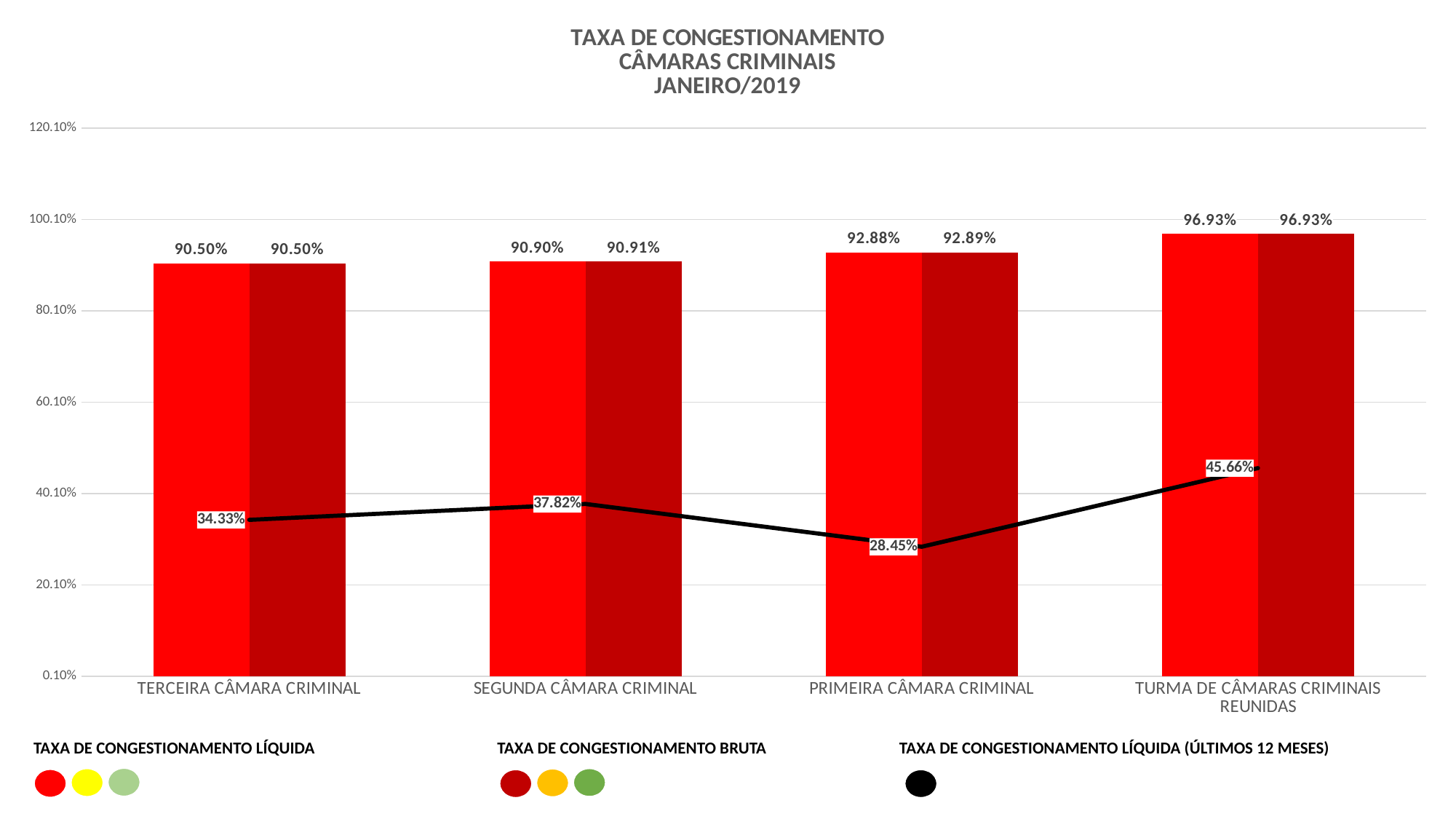
Which category has the highest Taxa de Congestionamento Bruta? Turma de Câmaras Criminais Reunidas What is the Taxa de Congestionamento Bruta for Segunda Câmara Criminal? 90.91% What is the Taxa de Congestionamento Líquida (últimos 12 meses) value for Primeira Câmara Criminal? 28.45% Which category has the lowest Taxa de Congestionamento Líquida (últimos 12 meses) value on the line? Primeira Câmara Criminal Which is larger: the Taxa de Congestionamento Líquida (últimos 12 meses) for Segunda Câmara Criminal or for Terceira Câmara Criminal? Segunda Câmara Criminal What kind of chart is shown on the slide? Combined bar and line chart What is the title of the chart? TAXA DE CONGESTIONAMENTO CÂMARAS CRIMINAIS JANEIRO/2019 What is the Taxa de Congestionamento Líquida for Terceira Câmara Criminal? 90.50% How many series does the legend list? 3 What is the difference between the Taxa de Congestionamento Líquida (últimos 12 meses) values for Turma de Câmaras Criminais Reunidas and Primeira Câmara Criminal? 17.21% How many categories are shown on the x axis? 4 What is the Taxa de Congestionamento Líquida (últimos 12 meses) value for Turma de Câmaras Criminais Reunidas? 45.66%